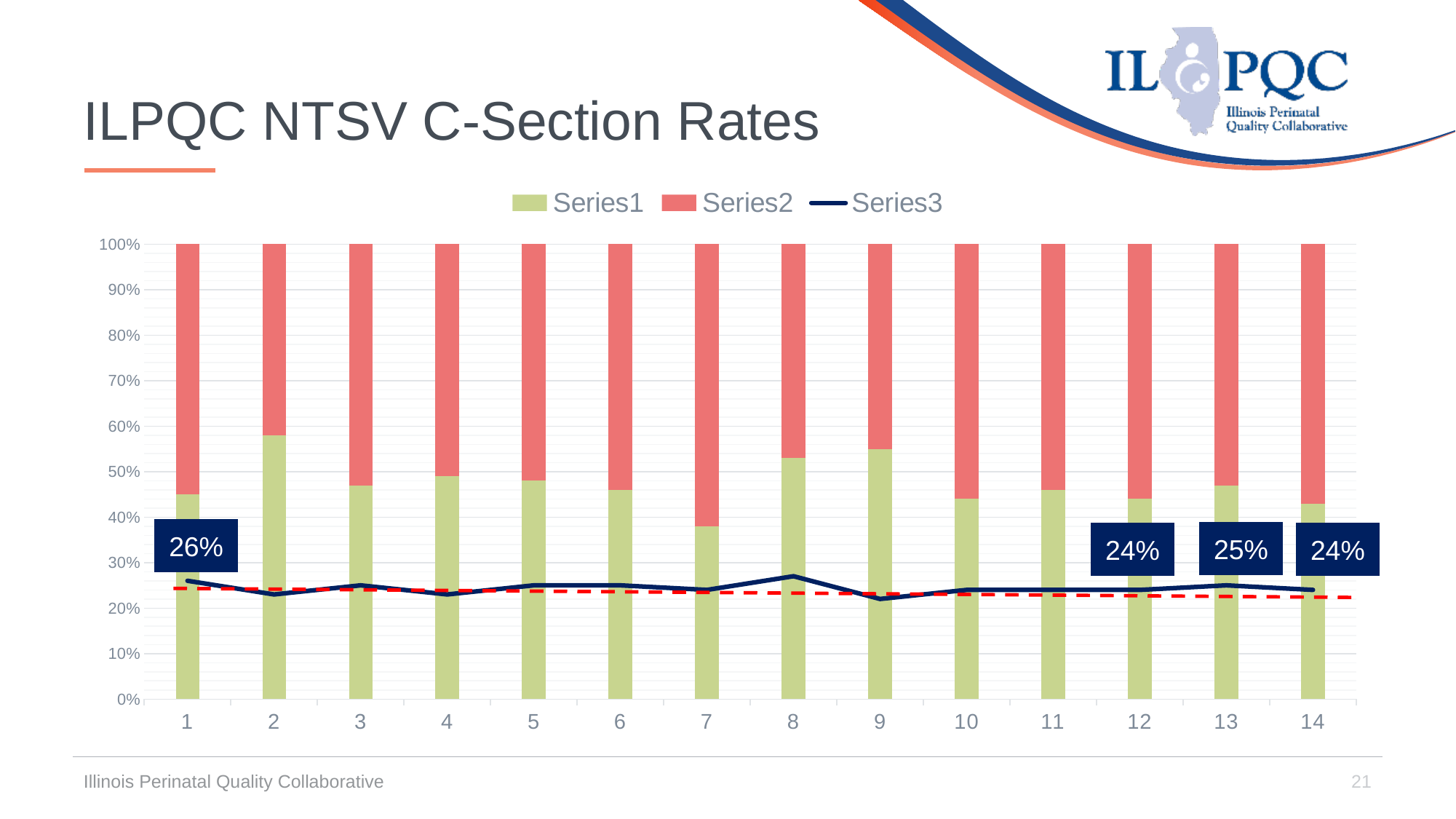
What is the title of the slide? ILPQC NTSV C-Section Rates What is the difference between the Series3 values at category 1 and category 12? 2% What is the Series3 value at category 1? 26% Is the Series1 value at category 7 greater or less than 50%? less What is the Series3 value at category 14? 24% What kind of chart is shown on the slide? Stacked bar chart with a line Is the Series1 value at category 2 greater or less than 50%? greater How many series does the legend list? 3 Which is larger, the Series3 value at category 1 or at category 13? Category 1 At which category is the Series1 value lowest? 7 How many categories are shown on the x axis? 14 What is the Series3 value at category 13? 25%